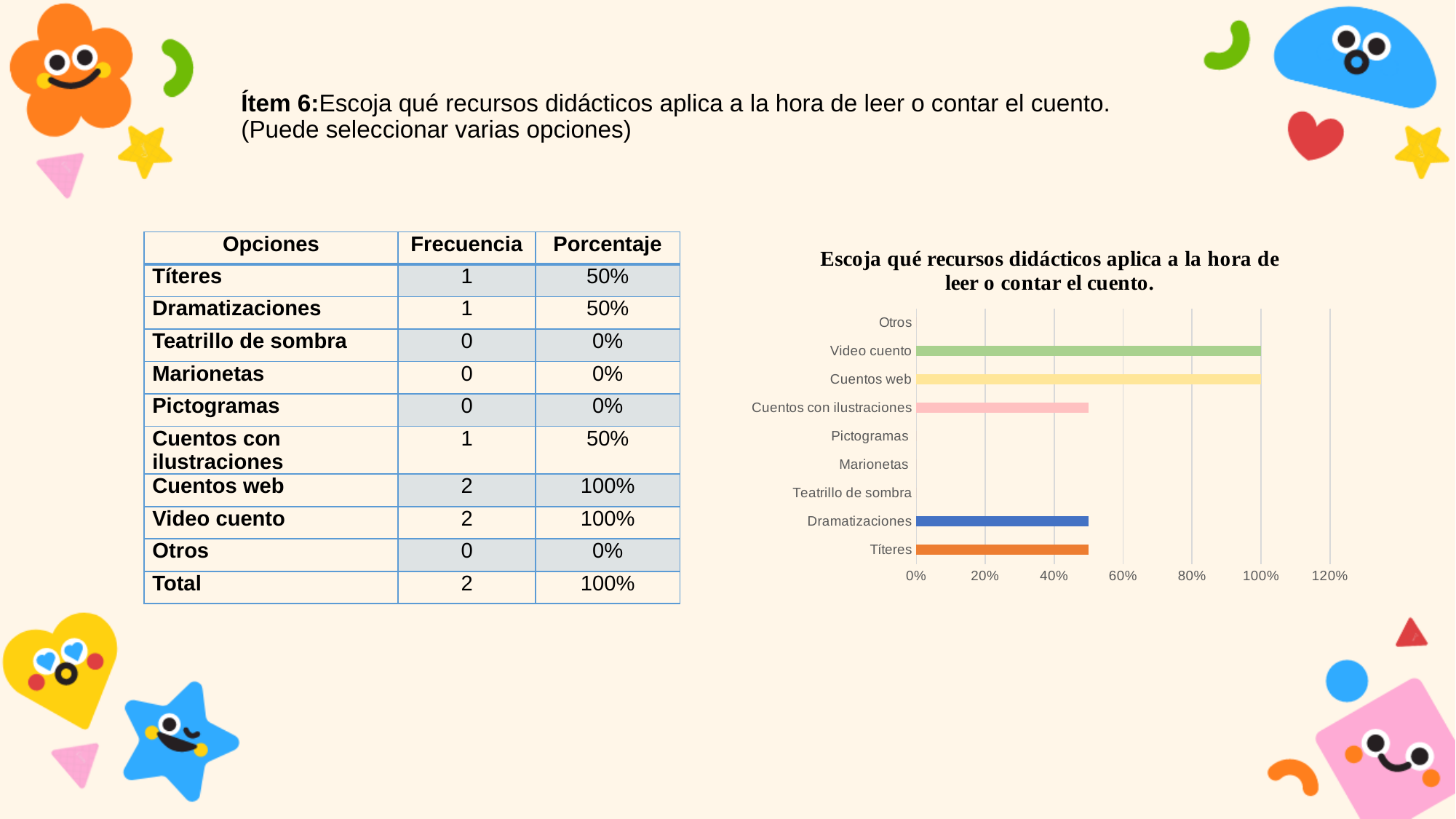
What is the value for Títeres in the bar chart? 50% How many categories in the bar chart have no visible bar (a value of 0%)? 4 What is the value for Video cuento in the bar chart? 100% Is the value for Dramatizaciones greater or less than 40%? greater What is the title of the bar chart? Escoja qué recursos didácticos aplica a la hora de leer o contar el cuento. What colour is the bar for Títeres? orange What kind of chart is shown on the slide? bar chart Which is larger in the bar chart, Video cuento or Títeres? Video cuento How many categories are listed on the vertical axis of the bar chart? 9 Is the value for Cuentos con ilustraciones greater or less than 60%? less What is the value for Cuentos web in the bar chart? 100% What is the difference between the values for Cuentos web and Títeres? 50%